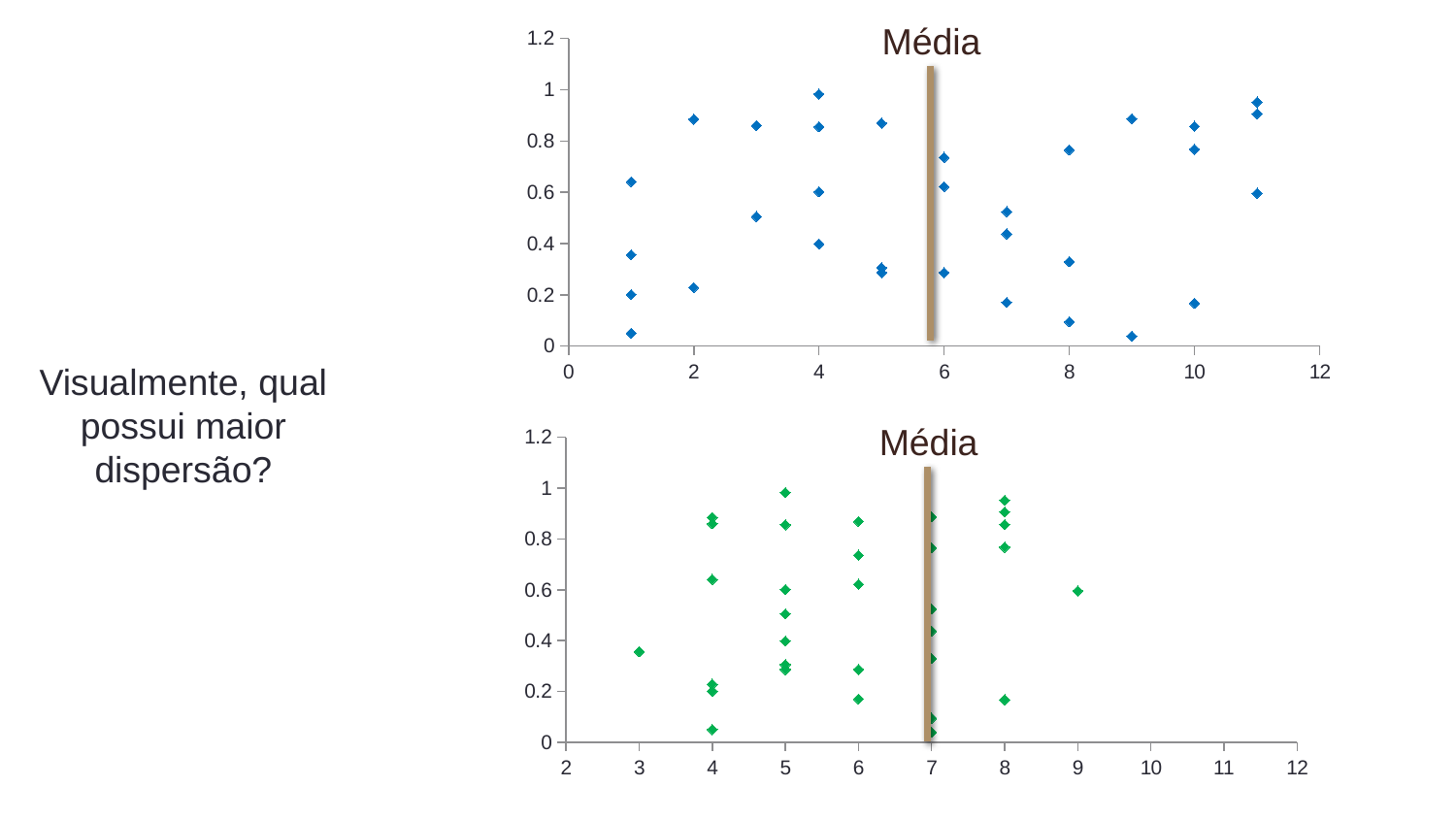
In the bottom chart, what is the lowest value shown on the x axis? 2 In the bottom chart, is the highest point at x = 5 greater or less than 0.8? greater In the bottom chart, is the lowest point at x = 8 greater or less than 0.4? less In the top chart, is the highest point at x = 4 greater or less than 0.8? greater In the top chart, what is the highest value shown on the y axis? 1.2 What kind of chart is the top chart on the slide? scatter chart What kind of chart is the bottom chart on the slide? scatter chart